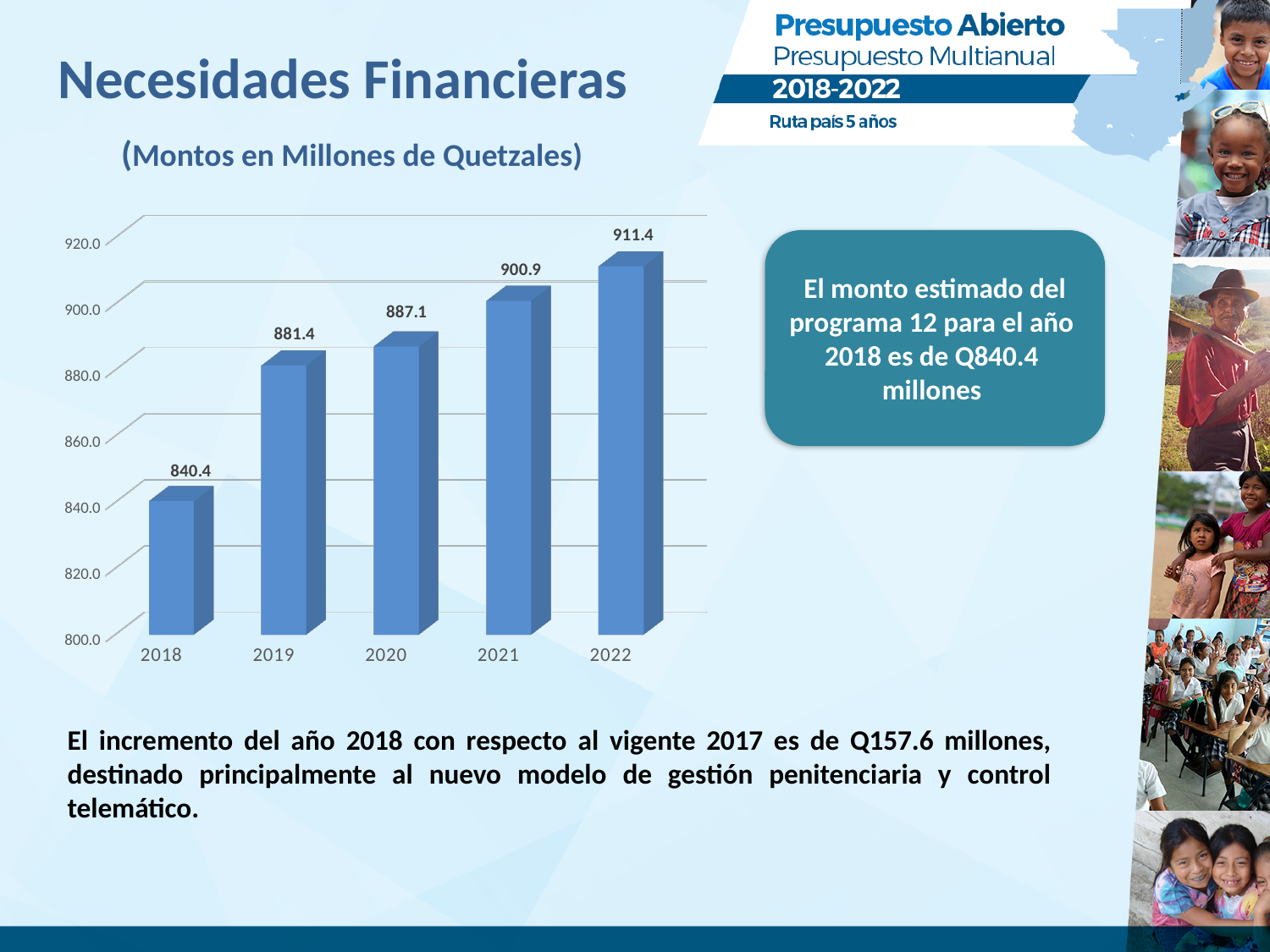
What is the value for 2022? 911.4 How many years are shown on the chart? 5 Which is larger, the value for 2021 or the value for 2019? 2021 What is the value for 2018? 840.4 Which year has the highest value? 2022 What is the difference between the values for 2022 and 2018? 71.0 Do the values rise or fall from 2018 to 2022? rise What is the value for 2020? 887.1 Is the value for 2021 greater or less than 880.0? greater What kind of chart is shown on the slide? bar chart What is the difference between the values for 2019 and 2018? 41.0 Which year has the lowest value? 2018